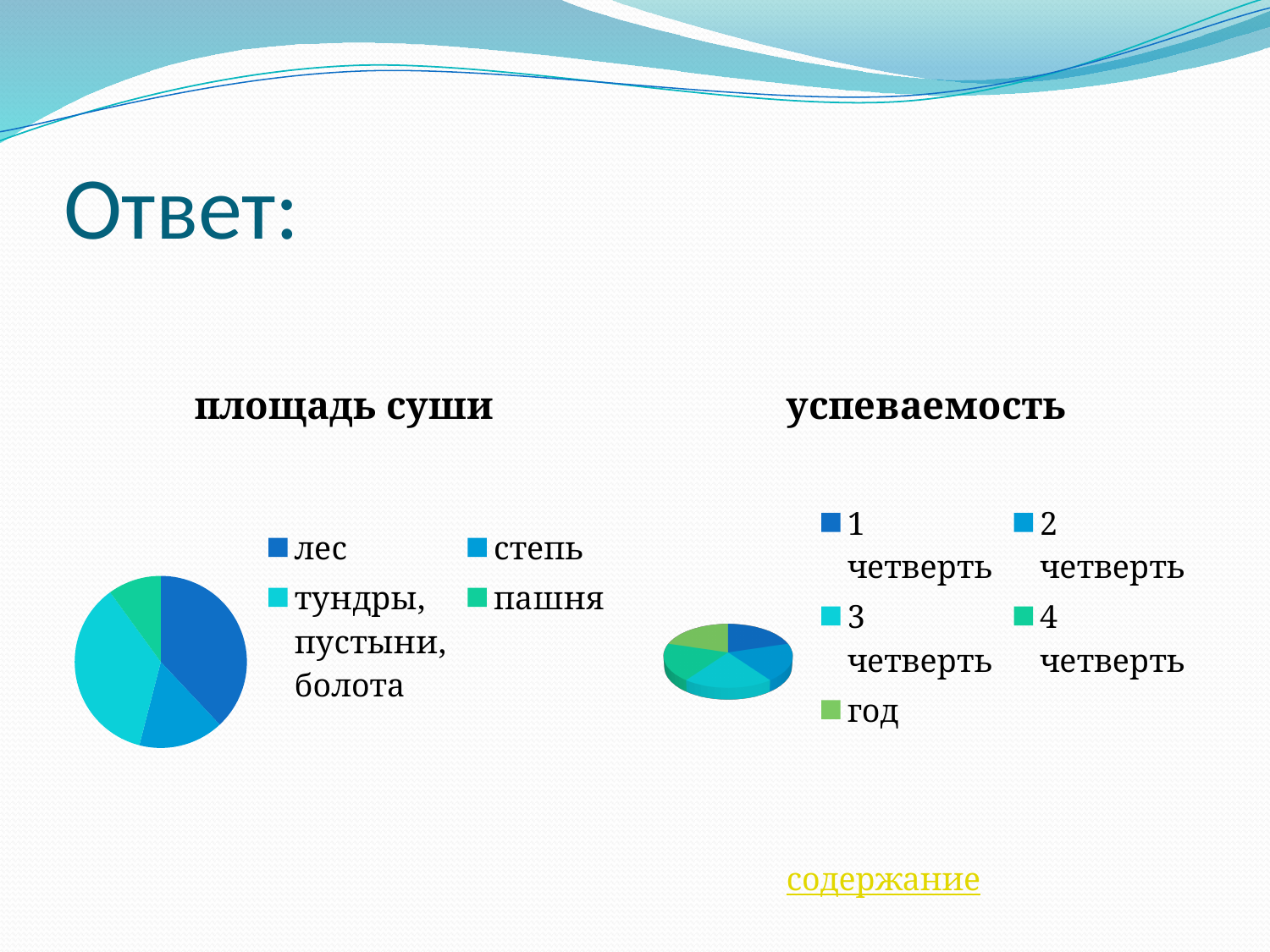
How many categories does the legend of the "успеваемость" chart list? 5 What is the title of the chart on the left side of the slide? площадь суши What kind of chart is the "успеваемость" chart? pie chart How many categories does the legend of the "площадь суши" chart list? 4 In the "успеваемость" chart, which legend entry is shown in light green? год In the "площадь суши" chart, which category has the smallest slice? пашня In the "площадь суши" chart, which slice is larger: степь or пашня? степь What kind of chart is the "площадь суши" chart? pie chart